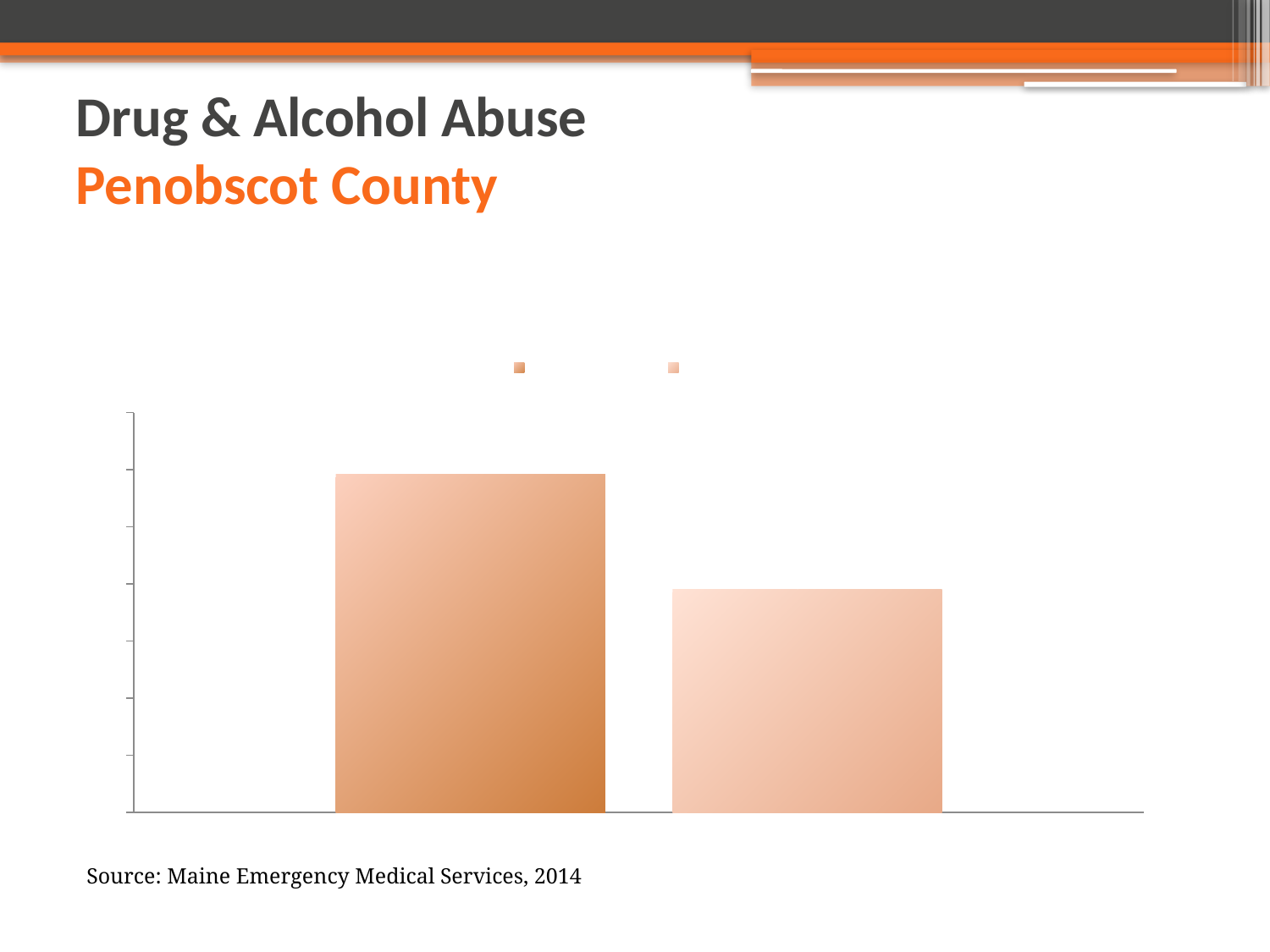
How many bars are plotted in the chart? 2 Which bar is taller, the left bar or the right bar? the left bar Which county is named in the slide title above the chart? Penobscot County What kind of chart is shown on the slide? bar chart Which bar has the lowest value in the chart? the right bar What source is cited below the chart? Maine Emergency Medical Services, 2014 Which bar has the highest value in the chart? the left bar How many entries does the chart's legend show? 2 Do the bar values rise or fall from left to right across the chart? fall